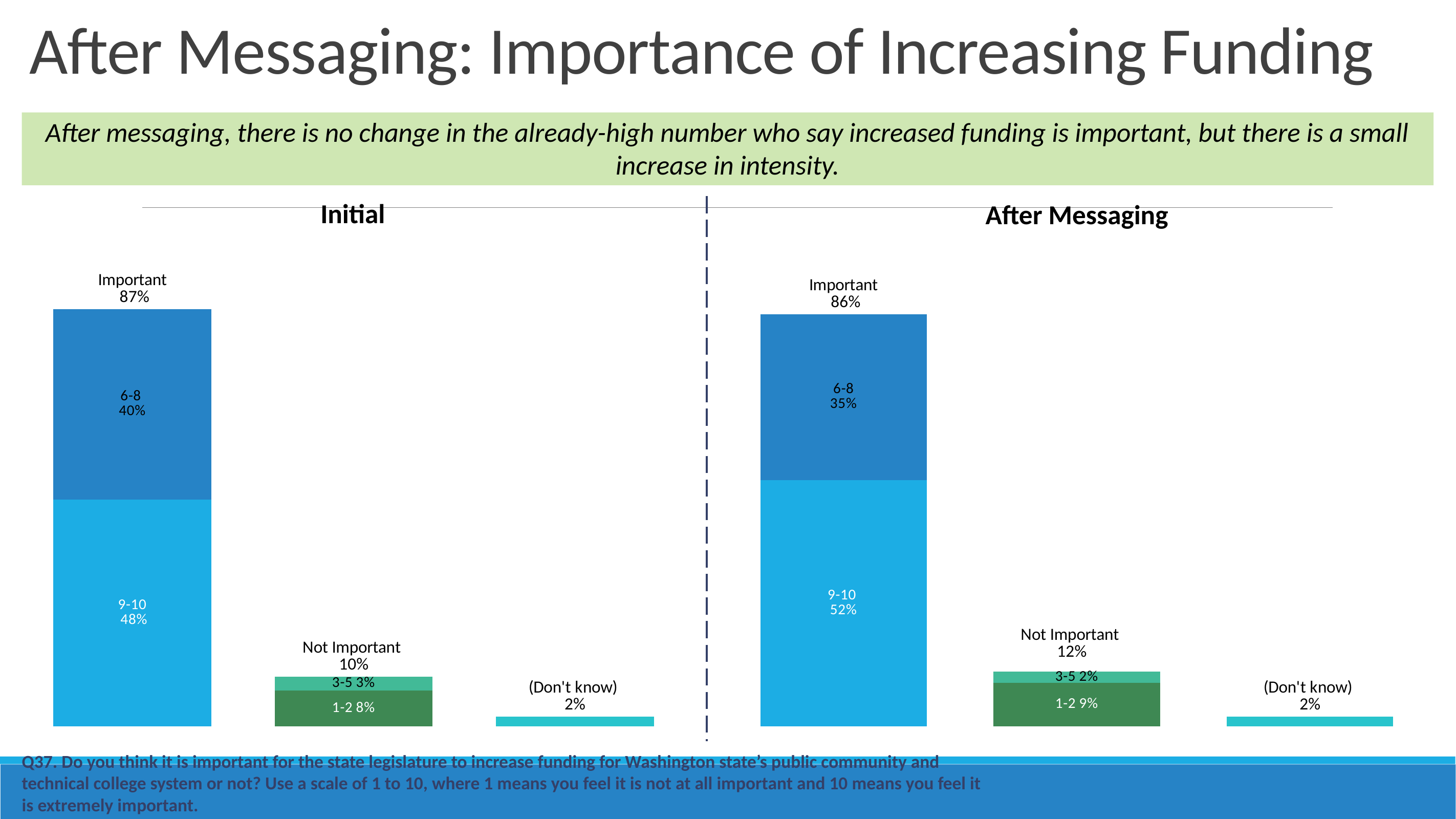
In the After Messaging chart, which category has the highest value? Important In the Initial chart, what percentage rate the importance 6-8? 40% In the After Messaging chart, what percentage rate the importance 9-10? 52% In the After Messaging chart, what percentage rate the importance 1-2? 9% In the After Messaging chart, what is the total for the Not Important bar? 12% In the Initial chart, what percentage say increasing funding is Important? 87% In the Initial chart, which category has the lowest value? (Don't know) How many categories are shown in the Initial chart? 3 Which is larger: the 6-8 share in the Initial chart or the 6-8 share in the After Messaging chart? Initial In the Initial chart, what percentage answered Don't know? 2% What type of chart is used on this slide? Stacked bar chart What is the difference between the 9-10 share in the After Messaging chart and the 9-10 share in the Initial chart? 4%